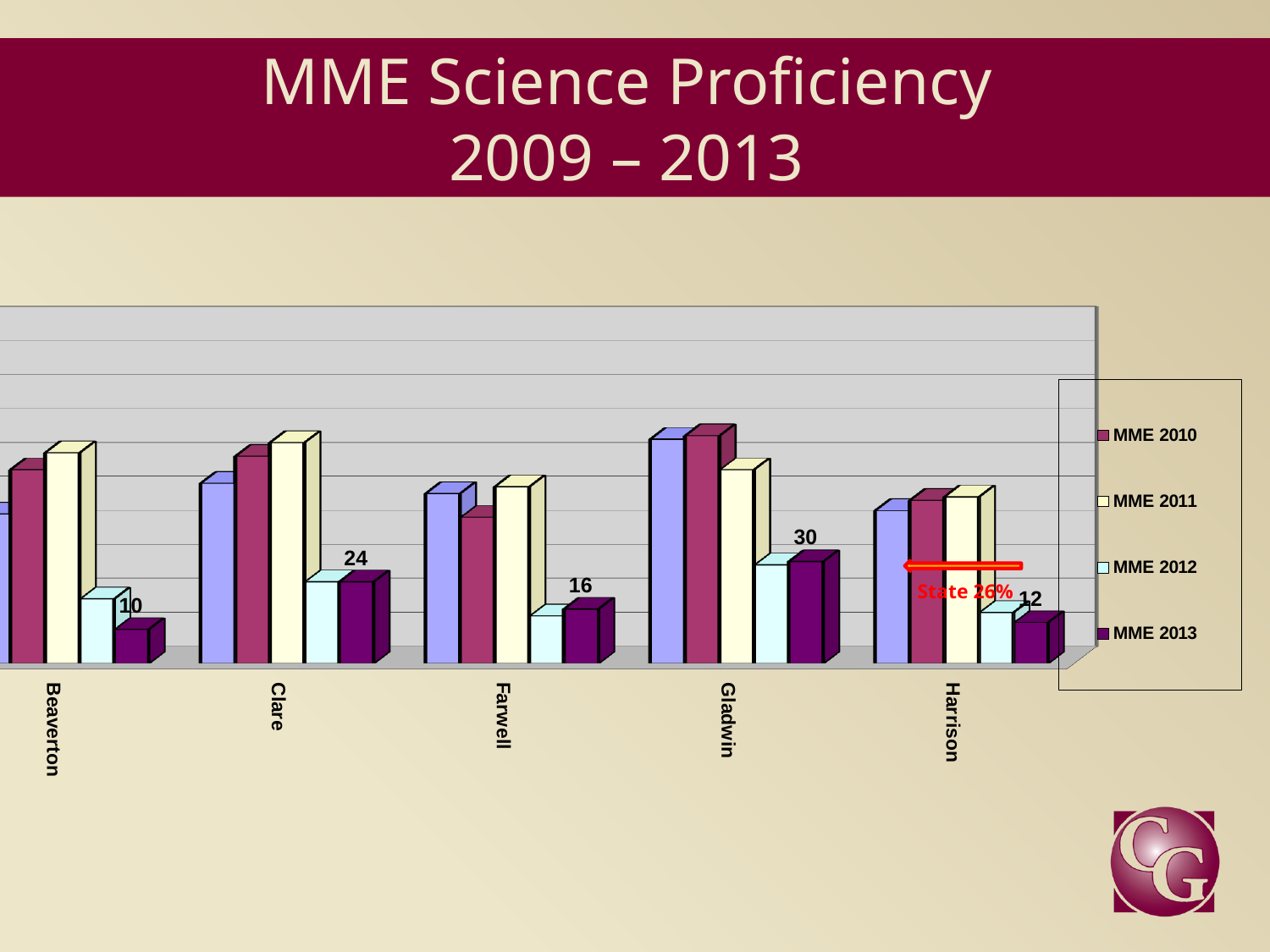
What is the MME 2013 value for Clare? 24 What is the MME 2013 value for Farwell? 16 What state value is annotated in red on the chart? State 26% Which has the larger MME 2013 value, Farwell or Harrison? Farwell What kind of chart is shown on the slide? bar chart What is the MME 2013 value for Gladwin? 30 Which district has the highest MME 2013 value? Gladwin Which district has the lowest MME 2013 value? Beaverton What is the MME 2013 value for Beaverton? 10 How many districts are shown on the x axis of the chart? 5 What is the difference between the MME 2013 values for Gladwin and Clare? 6 What is the MME 2013 value for Harrison? 12